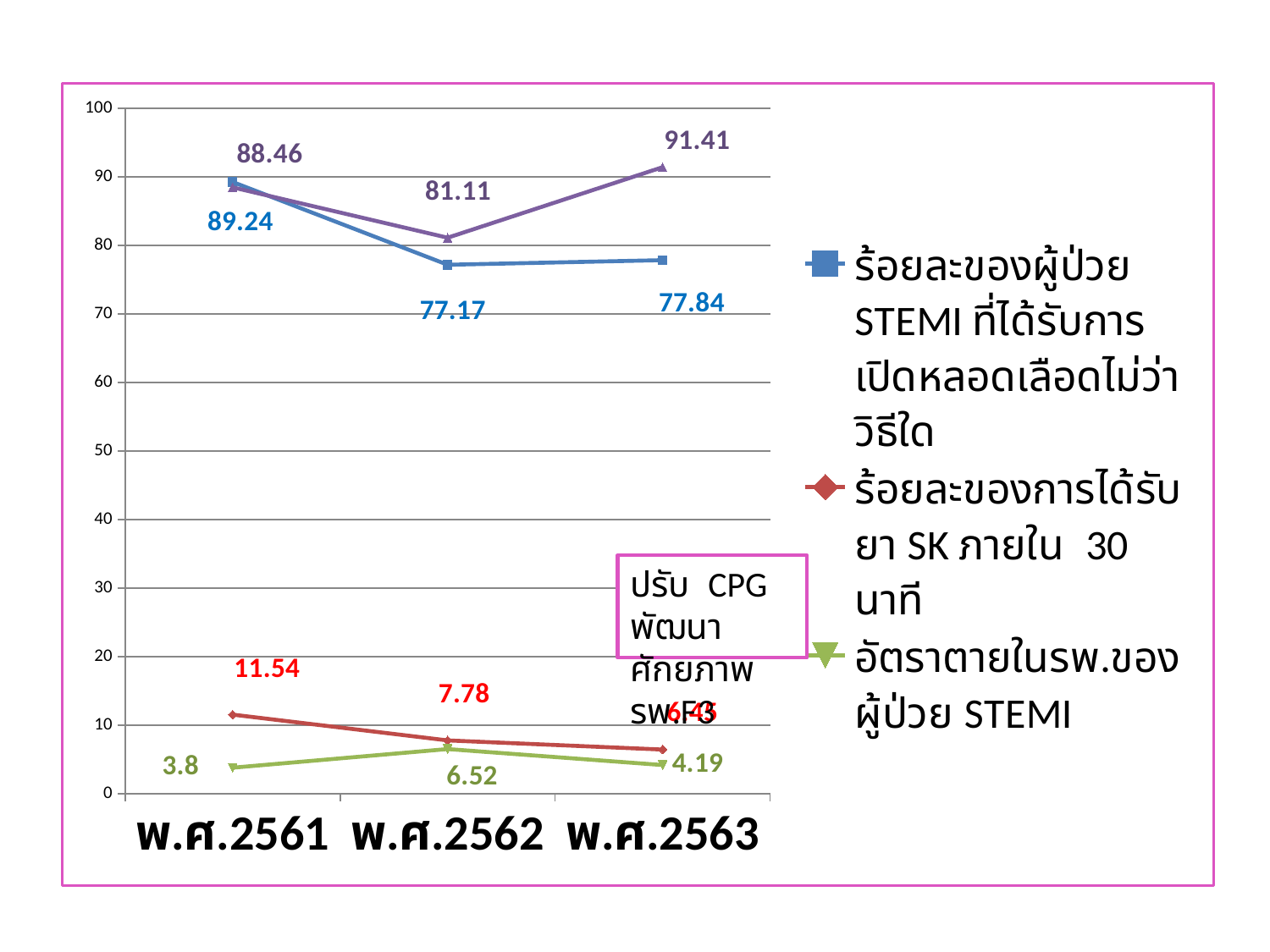
By how much did ร้อยละของผู้ป่วย STEMI ที่ได้รับการเปิดหลอดเลือดไม่ว่าวิธีใด fall from พ.ศ.2561 to พ.ศ.2562? 12.07 How many series does the legend list? 3 What kind of chart is shown on the slide? line chart In which year is ร้อยละของผู้ป่วย STEMI ที่ได้รับการเปิดหลอดเลือดไม่ว่าวิธีใด lowest? พ.ศ.2562 What is the value of ร้อยละของการได้รับยา SK ภายใน 30 นาที in พ.ศ.2562? 7.78 What is the value of ร้อยละของผู้ป่วย STEMI ที่ได้รับการเปิดหลอดเลือดไม่ว่าวิธีใด in พ.ศ.2561? 89.24 What is the value of อัตราตายในรพ.ของผู้ป่วย STEMI in พ.ศ.2562? 6.52 In which year is อัตราตายในรพ.ของผู้ป่วย STEMI highest? พ.ศ.2562 What is the value of ร้อยละของผู้ป่วย STEMI ที่ได้รับการเปิดหลอดเลือดไม่ว่าวิธีใด in พ.ศ.2562? 77.17 What is the value of ร้อยละของการได้รับยา SK ภายใน 30 นาที in พ.ศ.2561? 11.54 Does ร้อยละของการได้รับยา SK ภายใน 30 นาที rise or fall from พ.ศ.2561 to พ.ศ.2563? fall Which year has the larger value for ร้อยละของผู้ป่วย STEMI ที่ได้รับการเปิดหลอดเลือดไม่ว่าวิธีใด, พ.ศ.2561 or พ.ศ.2563? พ.ศ.2561